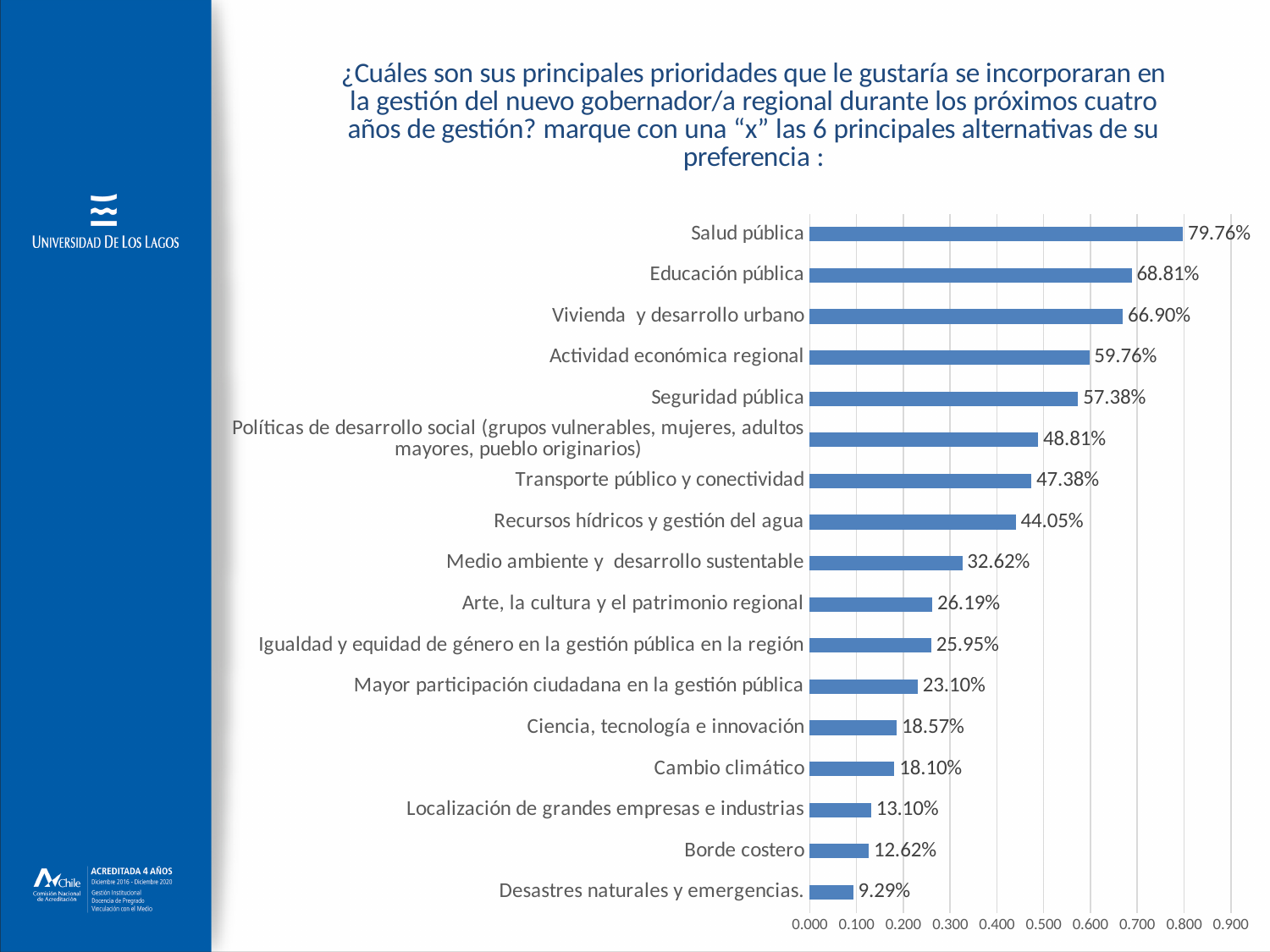
What kind of chart is shown on the slide? Bar chart What is the value for Transporte público y conectividad? 47.38% What is the value for Cambio climático? 18.10% Is the value for Recursos hídricos y gestión del agua greater or less than 0.500? less Which category has the lowest value? Desastres naturales y emergencias. Which is larger, the value for Seguridad pública or the value for Actividad económica regional? Actividad económica regional What is the difference between the values for Salud pública and Educación pública? 10.95% What is the value for Salud pública? 79.76% What is the difference between the values for Borde costero and Desastres naturales y emergencias.? 3.33% Which category has the highest value? Salud pública How many categories are shown in the chart? 17 What is the highest tick value shown on the horizontal axis? 0.900